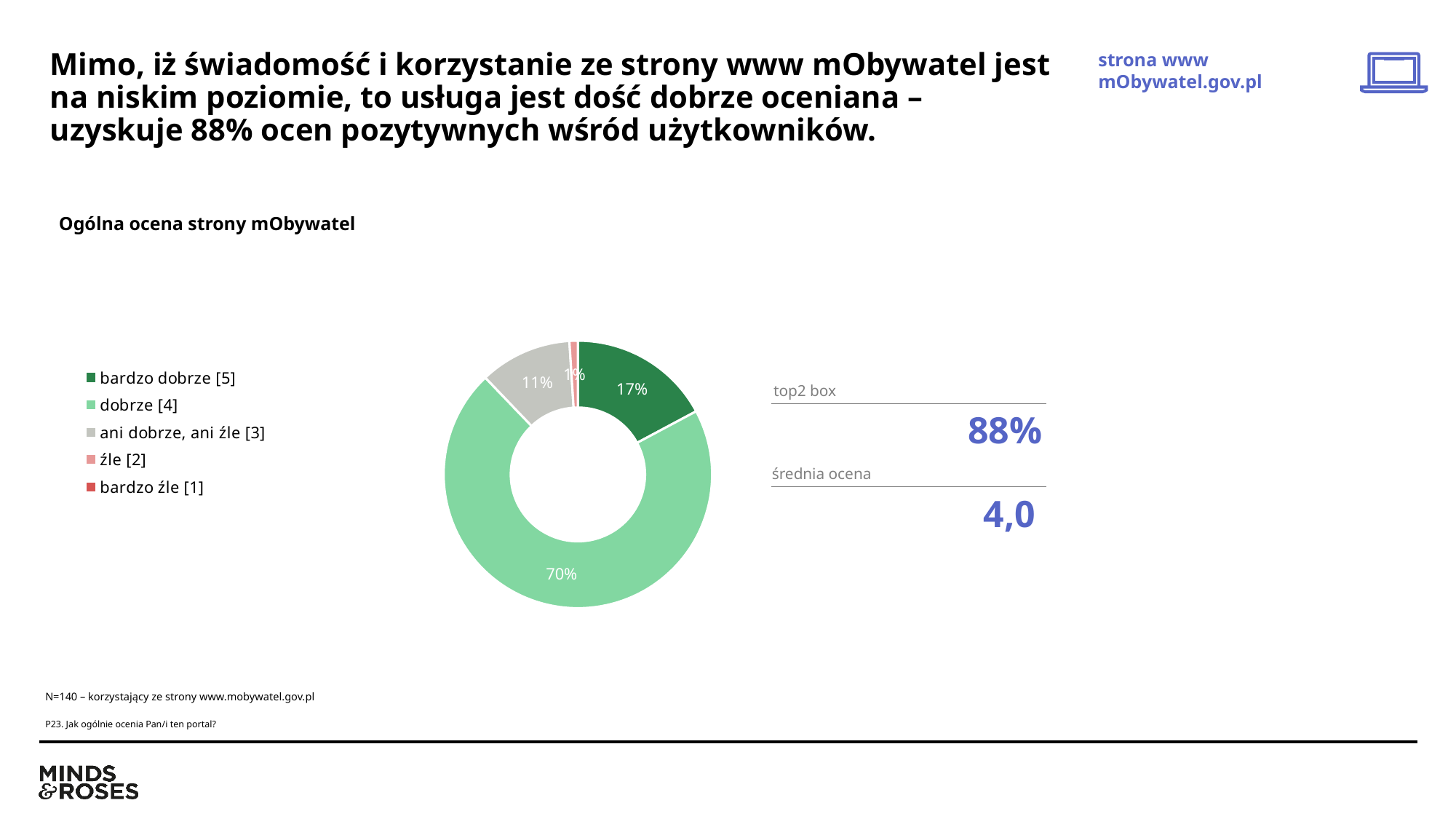
What type of chart is shown on the slide? donut (pie) chart What is the average rating (średnia ocena) shown next to the chart? 4,0 What is the title of the chart? Ogólna ocena strony mObywatel Which rating category has the largest share of the chart? dobrze [4] What percentage of respondents rated the site 'dobrze [4]'? 70% What percentage of respondents rated the site 'źle [2]'? 1% What is the difference in percentage points between 'dobrze [4]' and 'bardzo dobrze [5]'? 53 What percentage of respondents rated the site 'ani dobrze, ani źle [3]'? 11% How many entries does the chart legend list? 5 Which is larger: the share for 'bardzo dobrze [5]' or for 'ani dobrze, ani źle [3]'? bardzo dobrze [5] What is the top2 box value shown next to the chart? 88% What percentage of respondents rated the site 'bardzo dobrze [5]'? 17%